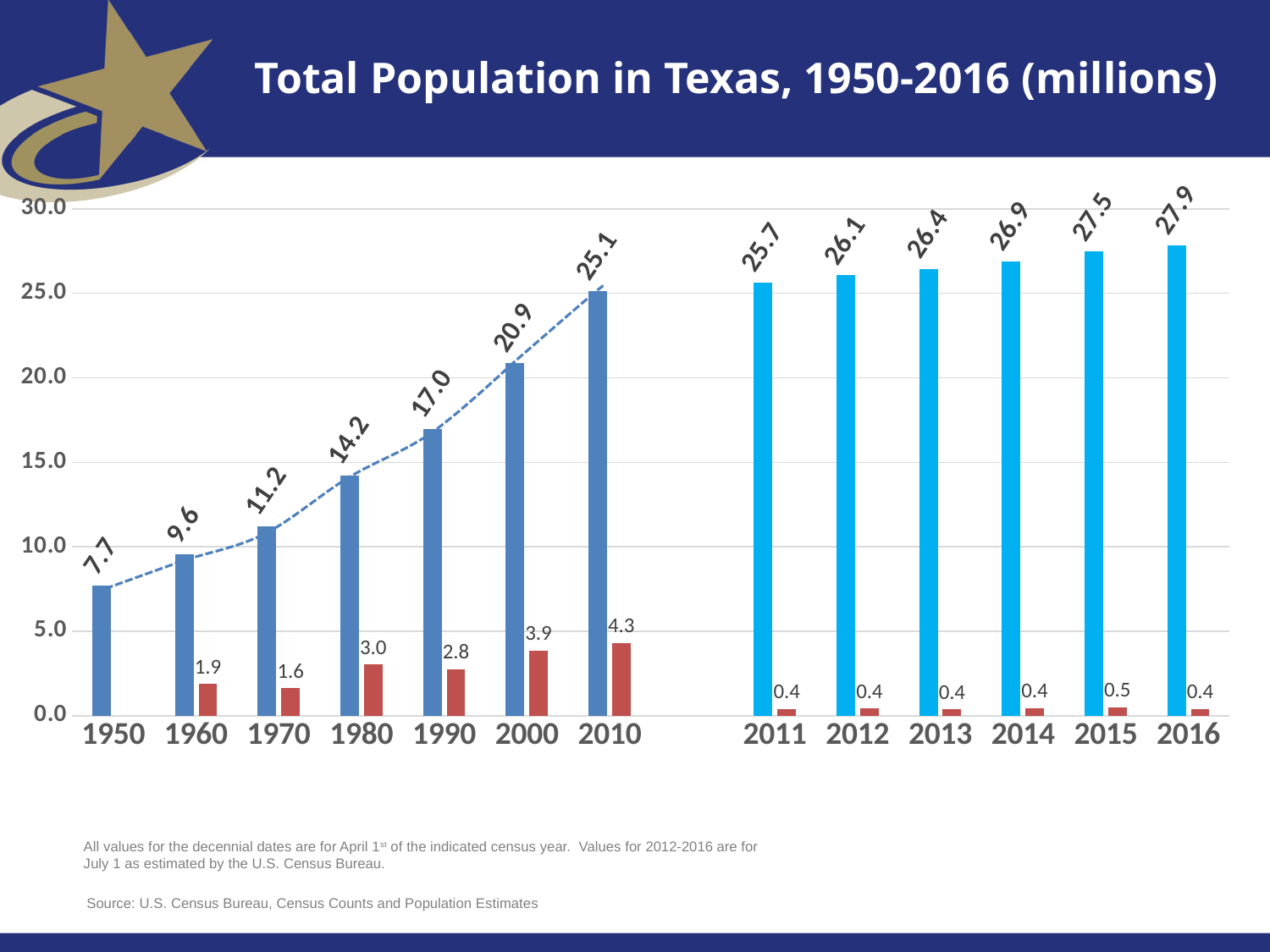
Which is larger, the red bar value for 1980 or for 1990? 1980 How many years are shown on the x axis of the chart? 13 What is the total population value shown for 2016? 27.9 What is the total population value shown for Texas in 1950? 7.7 What kind of chart is used to show the total population in Texas? Bar chart What is the difference between the total population values for 2016 and 1950? 20.2 Which year has the highest total population value on the chart? 2016 Which year has the lowest total population value on the chart? 1950 What is the value of the small red bar shown for 2015? 0.5 Which year has the tallest red bar on the chart? 2010 Do the total population values rise or fall from 1950 to 2016? Rise What is the value of the small red bar shown for 2010? 4.3